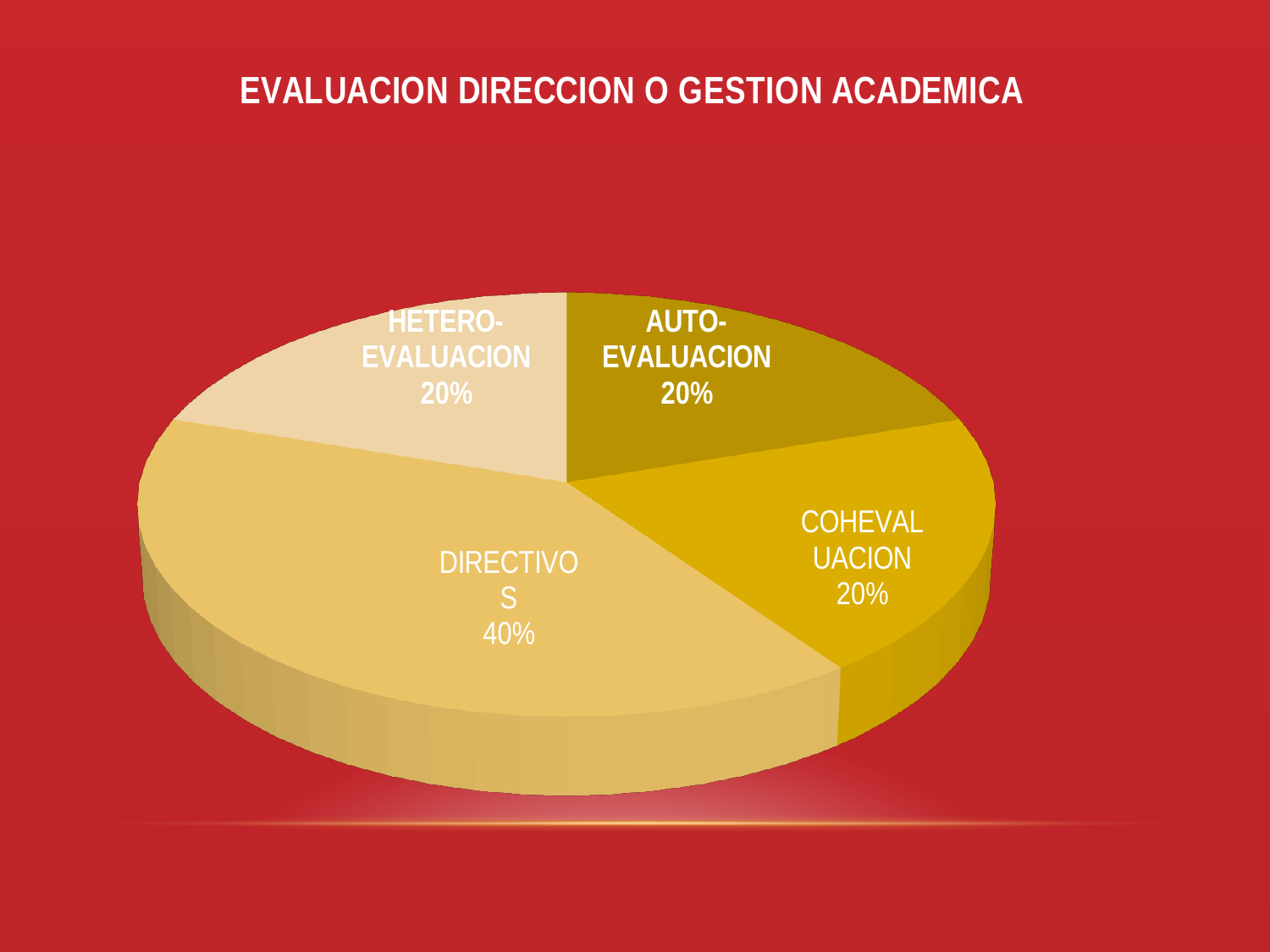
How many slices does the pie chart have? 4 What percentage is shown for DIRECTIVOS? 40% What kind of chart is shown on the slide? Pie chart Which category has the largest share of the pie? DIRECTIVOS Which is larger, the share for DIRECTIVOS or the share for HETERO-EVALUACION? DIRECTIVOS What is the difference between the DIRECTIVOS share and the COHEVALUACION share? 20% What percentage is shown for HETERO-EVALUACION? 20% What percentage is shown for AUTO-EVALUACION? 20% What is the combined share of AUTO-EVALUACION and COHEVALUACION? 40% How many slices show a value of 20%? 3 What is the title of the chart? EVALUACION DIRECCION O GESTION ACADEMICA What percentage is shown for COHEVALUACION? 20%